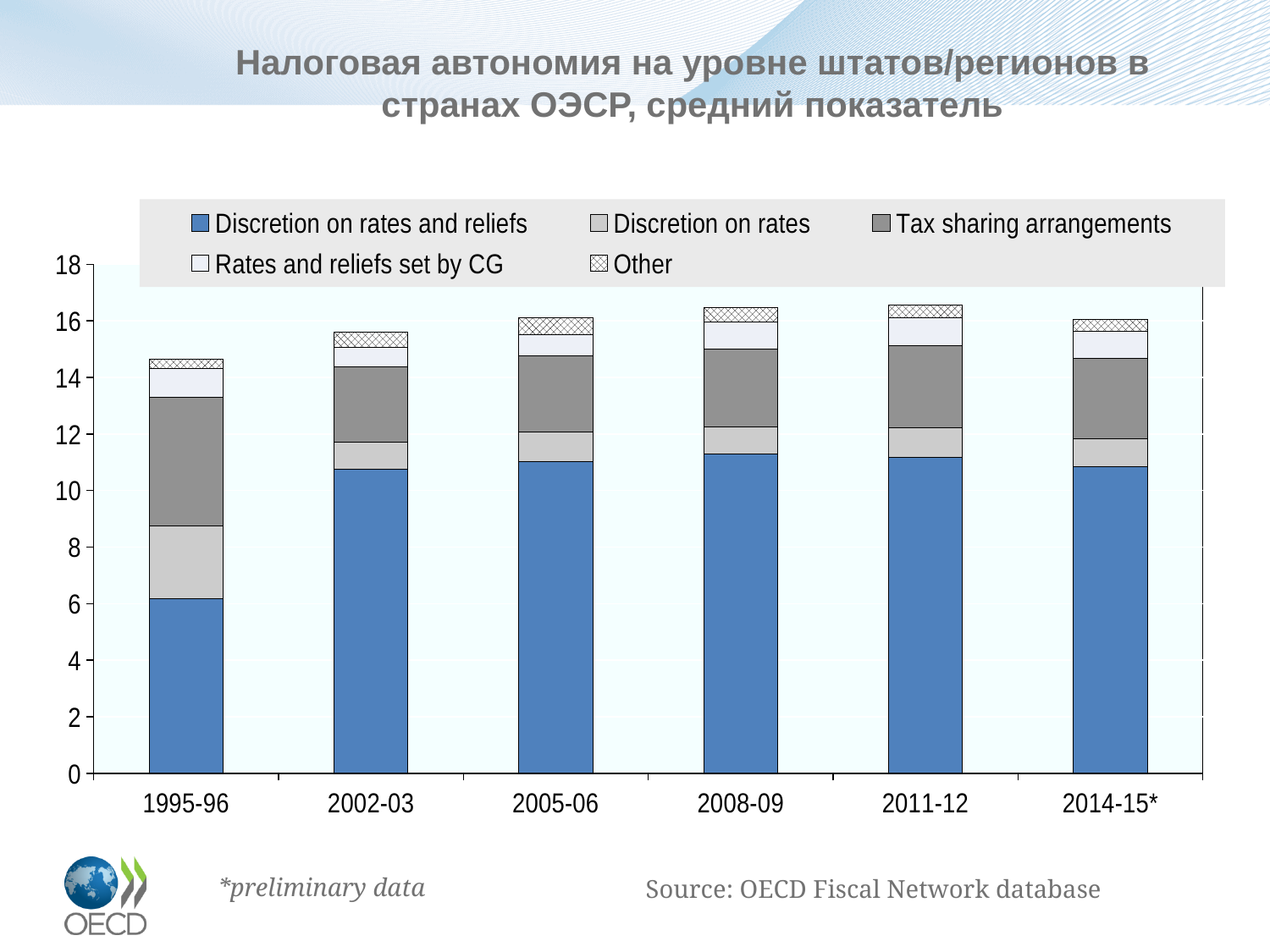
Is the total bar height for 1995-96 greater or less than 16? less Does the total bar height rise or fall from 1995-96 to 2008-09? rises Which legend entry is shown with a cross-hatched pattern? Other Which is larger, the 'Discretion on rates and reliefs' segment for 1995-96 or for 2002-03? 2002-03 Which period has the smallest 'Discretion on rates and reliefs' segment? 1995-96 Is the total bar height for 2008-09 greater or less than 16? greater Which period has the lowest total bar height? 1995-96 What kind of chart is shown on the slide? stacked bar chart How many series does the legend list? 5 Is the 'Discretion on rates and reliefs' value for 2002-03 greater or less than 10? greater How many periods (bars) are shown along the x axis? 6